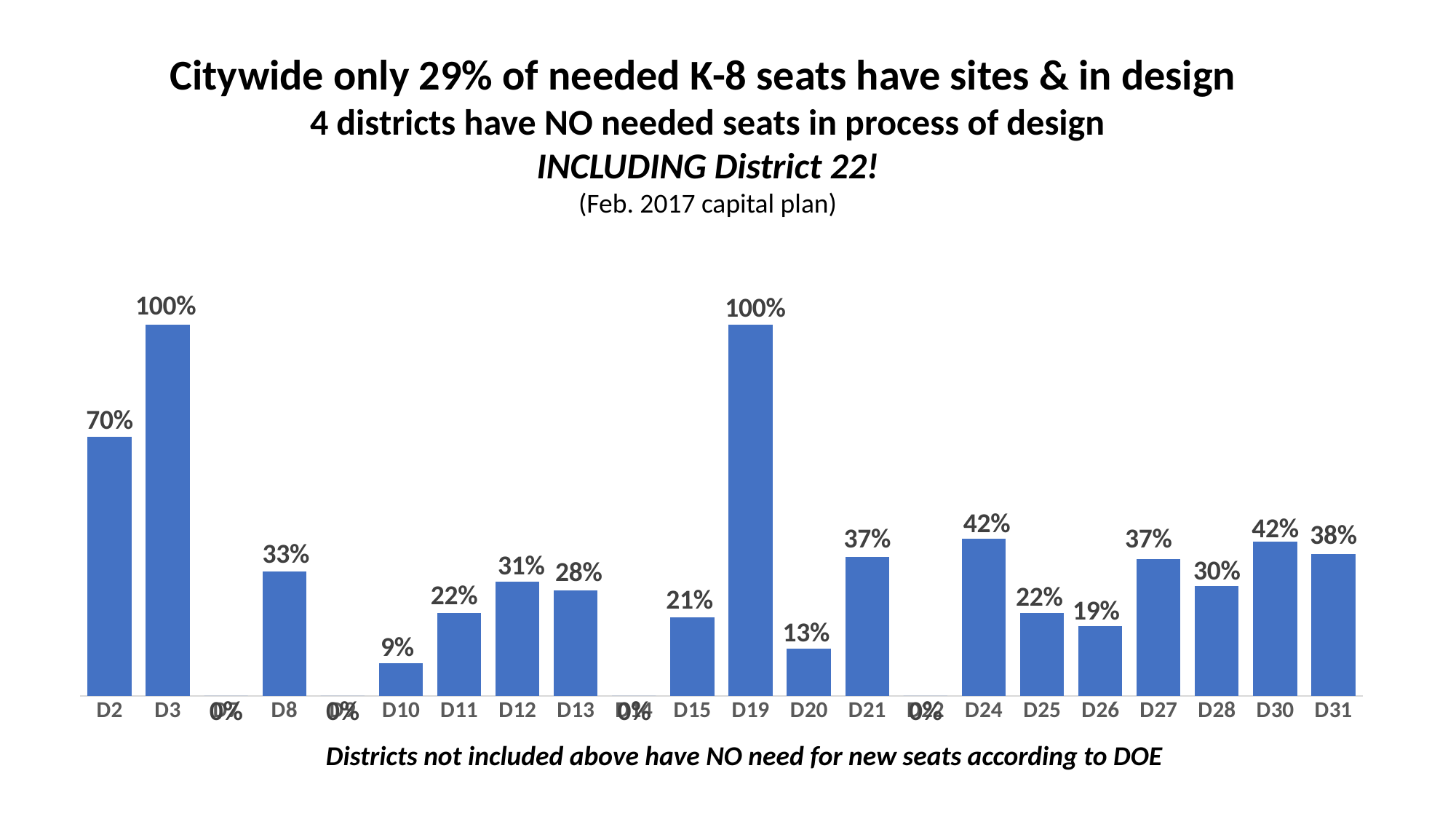
Which two districts reach 100%? D3 and D19 Which has a larger value, D26 or D28? D28 Which has a larger value, D12 or D13? D12 What is the value shown for D21? 37% What is the difference between the values for D24 and D20? 29% What is the value shown for D31? 38% What kind of chart is shown on the slide? Bar chart What is the value shown for D2? 70% What is the difference between the values for D2 and D8? 37% What is the value shown for D22? 0% According to the note below the chart, what is true of districts not included in the chart? They have NO need for new seats according to DOE What is the value shown for D10? 9%